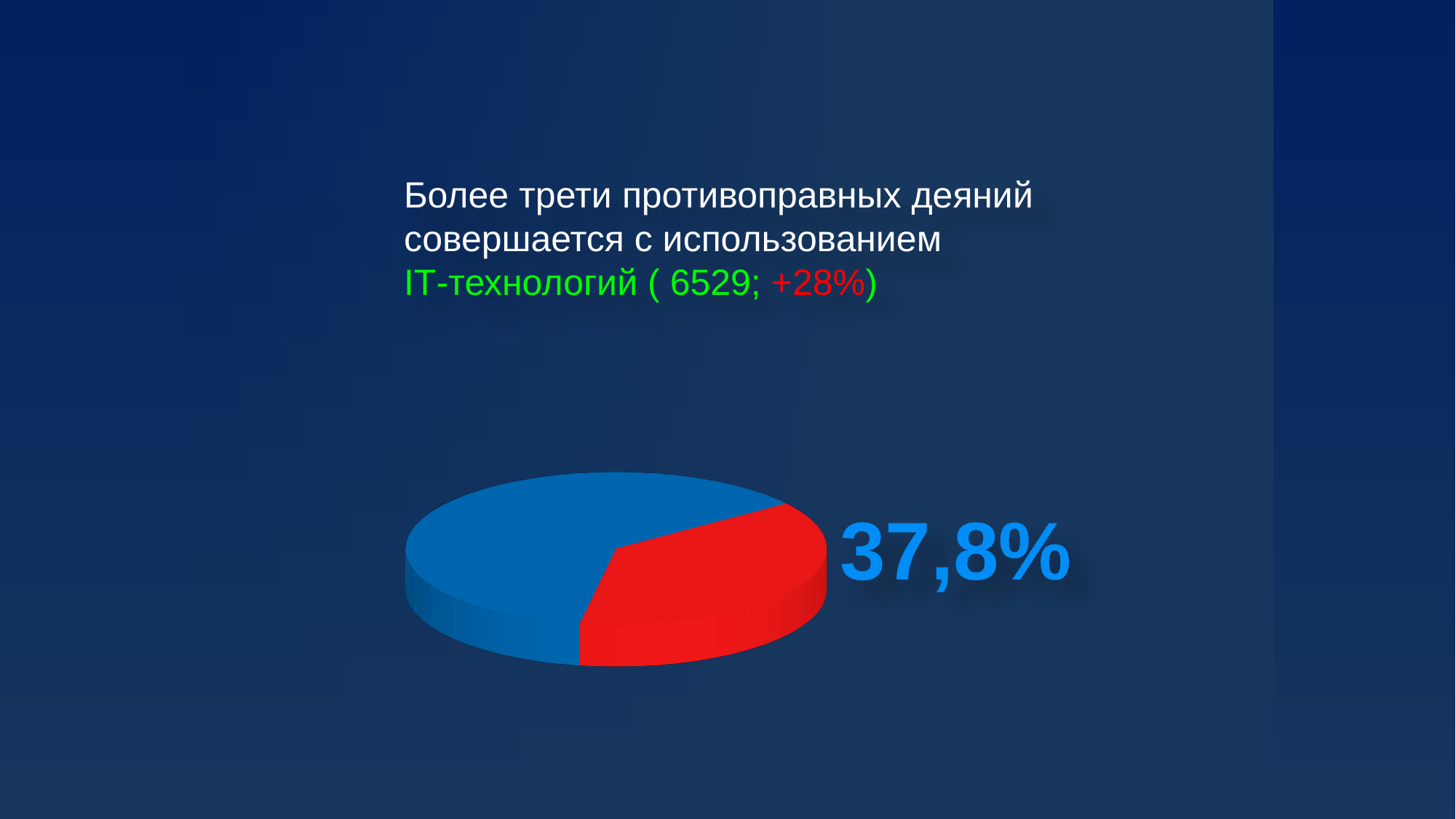
Is the share of the red slice greater or less than 30%? greater Which slice of the pie chart is larger, the blue one or the red one? blue Is the share of the red slice greater or less than 50%? less What percentage is printed next to the red slice of the pie chart? 37,8% What kind of chart is shown on the slide? pie chart What two colours are used for the slices of the pie chart? blue and red Does the pie chart have a legend? No How many slices does the pie chart have? 2 What share of the pie does the red slice represent? 37,8% Which slice of the pie chart is the smallest? the red slice